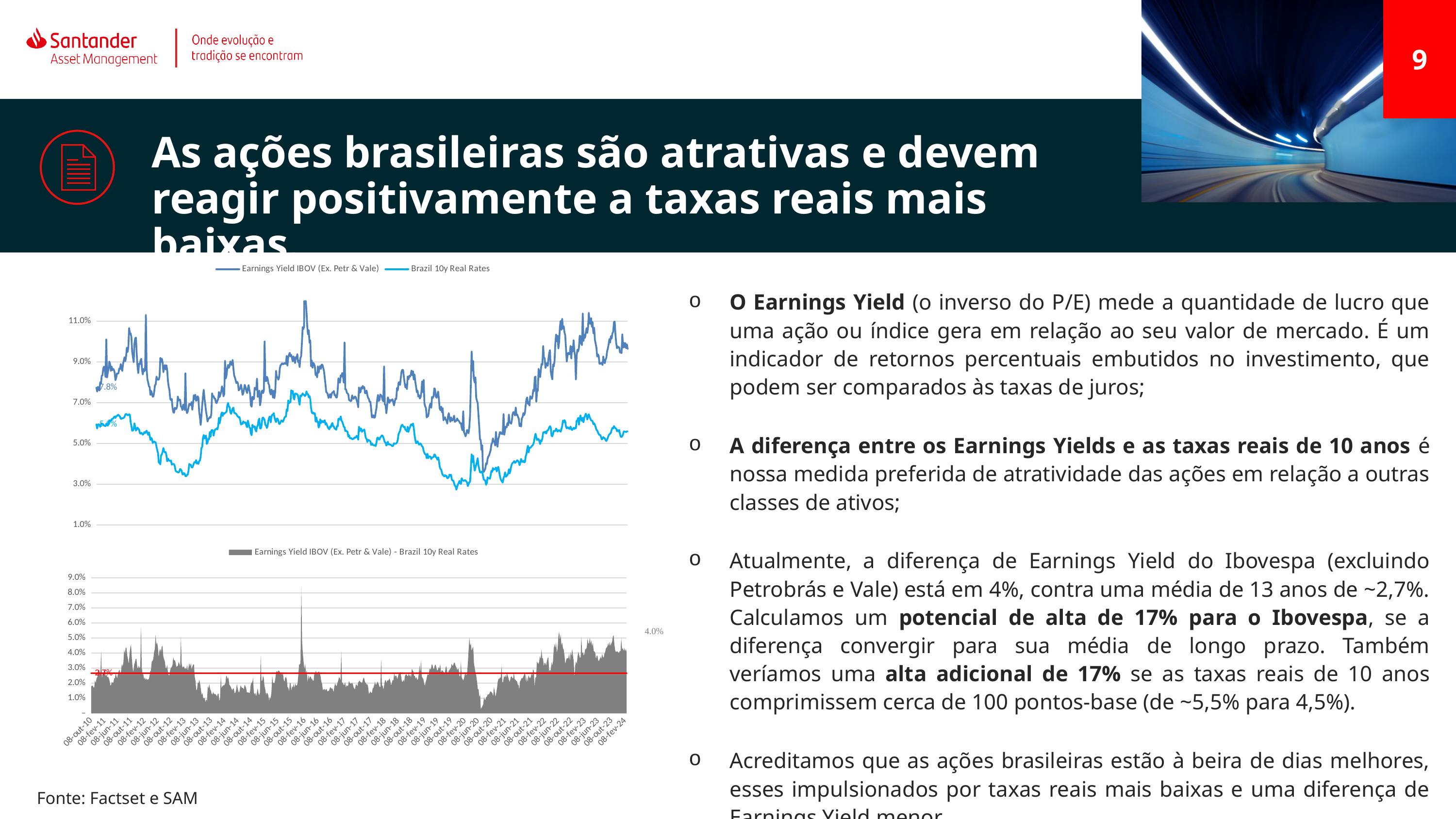
In the top chart, is the value of Earnings Yield IBOV (Ex. Petr & Vale) at the end of the period greater or less than 7.0%? greater In the bottom chart, what is the difference between the latest labelled value (4.0%) and the red line value (2.7%)? 1.3% In the top chart, at the end of the period, which series is higher: Earnings Yield IBOV (Ex. Petr & Vale) or Brazil 10y Real Rates? Earnings Yield IBOV (Ex. Petr & Vale) In the bottom chart, what value is labelled at the end of the Earnings Yield IBOV (Ex. Petr & Vale) - Brazil 10y Real Rates series? 4.0% How many series does the legend of the top chart list? 2 In the bottom chart, is the peak value around 2016 greater or less than 7.0%? greater How many series does the legend of the bottom chart list? 1 What are the two series named in the legend of the top chart? Earnings Yield IBOV (Ex. Petr & Vale) and Brazil 10y Real Rates In the top chart, is the value of Brazil 10y Real Rates at the end of the period greater or less than 7.0%? less In the top chart, what value is labelled at the start of the Earnings Yield IBOV (Ex. Petr & Vale) series? 7.8% What kind of chart is the top chart on the slide? Line chart In the bottom chart, what value is labelled on the red horizontal line? 2.7%